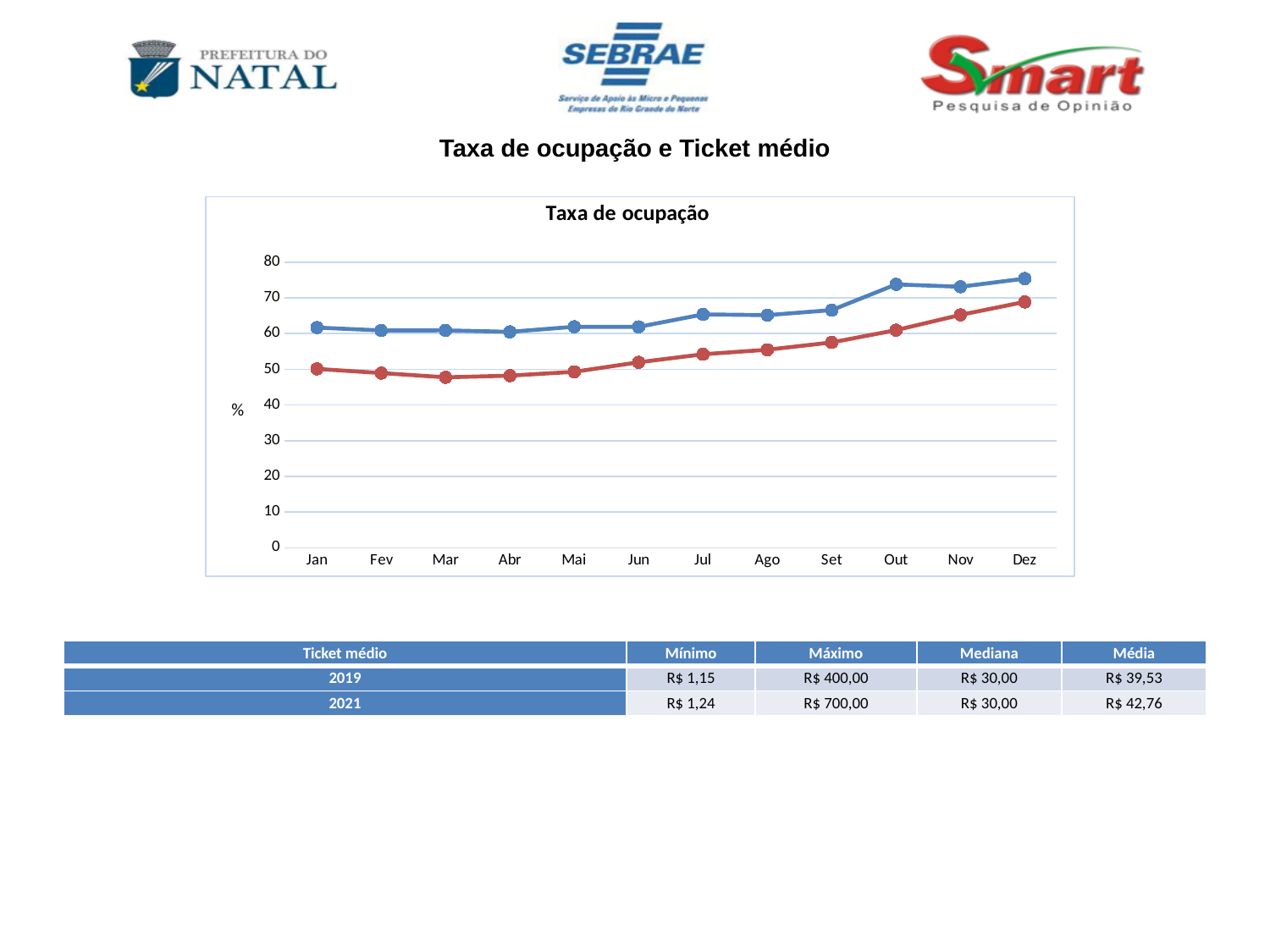
What is the title of the chart on the slide? Taxa de ocupação How many months are shown along the x axis of the chart? 12 Does the red line generally rise or fall from Jan to Dez? rise Is the value of the red line for Jul greater or less than 50? greater Is the value of the red line for Dez greater or less than 60? greater How many lines are plotted on the chart? 2 Is the value of the red line for Set greater or less than 60? less What kind of chart is shown on the slide? line chart In which month does the red line reach its highest value? Dez In Jan, which line has the higher value, the blue line or the red line? blue line